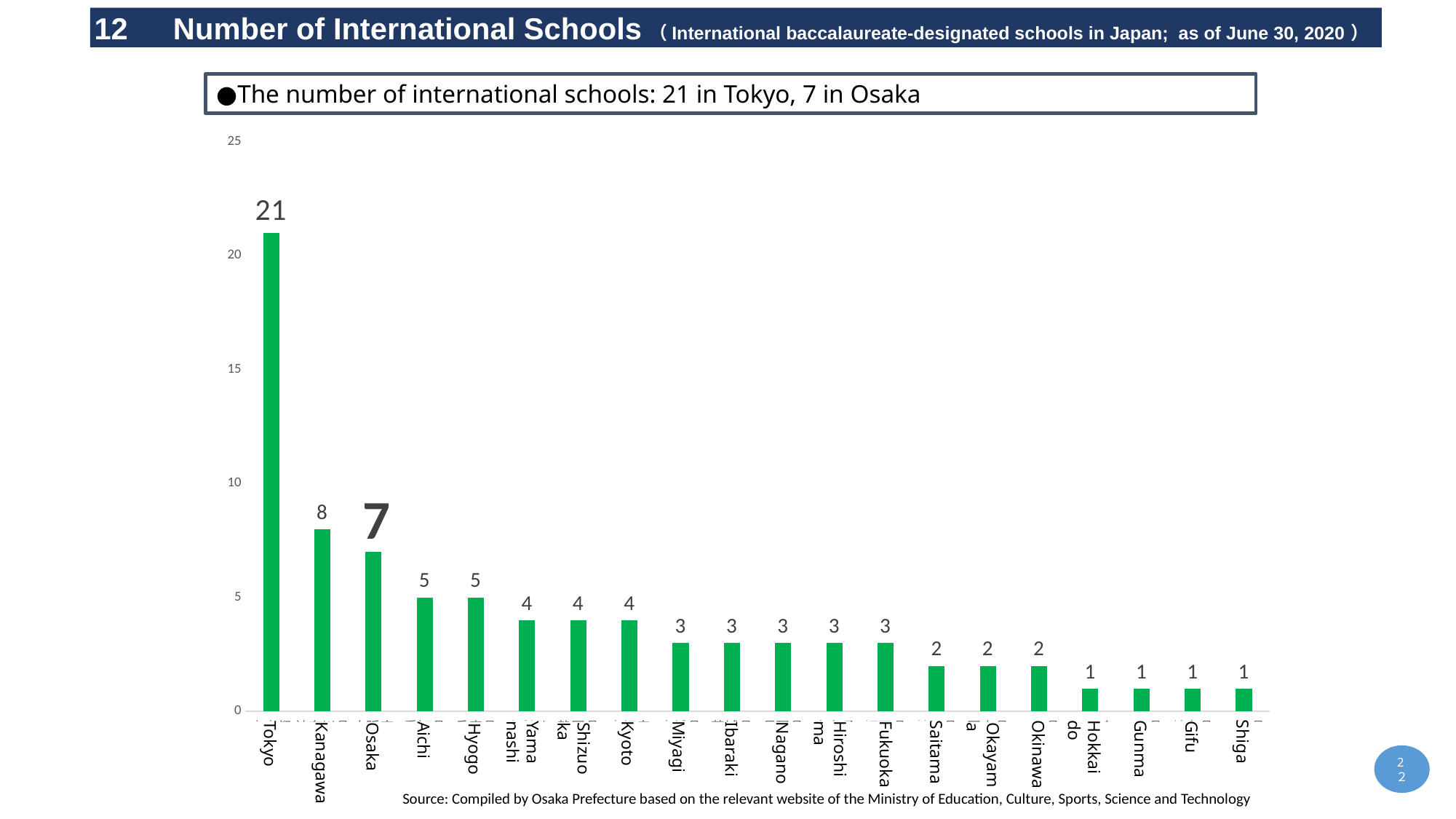
Which has a larger value, Osaka or Hyogo? Osaka What is the value shown for Osaka? 7 What is the value shown for Kanagawa? 8 What is the difference between the values for Kanagawa and Aichi? 3 How many prefectures are shown on the x axis of the chart? 20 What is the difference between the values for Tokyo and Osaka? 14 What kind of chart is shown on the slide? Bar chart Do the values rise or fall moving from left to right along the x axis? Fall What is the value shown for Kyoto? 4 Which prefecture has the highest number of international schools? Tokyo Is the value for Tokyo greater or less than 20? greater How many international schools does the chart show for Tokyo? 21